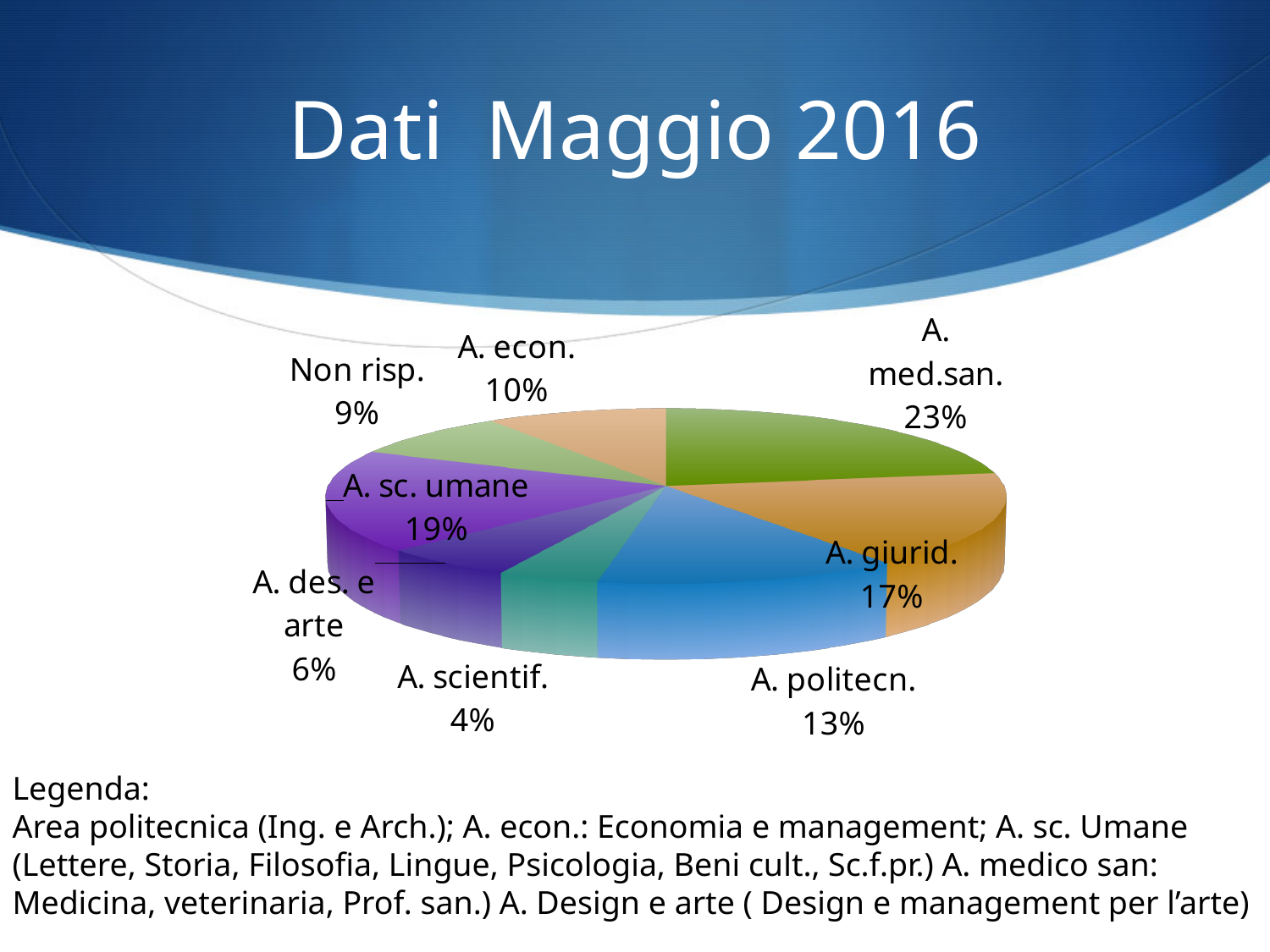
What is the value shown for A. politecn.? 13% What percentage is labelled for Non risp.? 9% Which category has the smallest slice of the pie? A. scientif. What is the difference in percentage points between A. econ. and A. des. e arte? 4 Which category has the largest slice of the pie? A. med.san. What is the title of the slide containing the chart? Dati Maggio 2016 What type of chart is shown on the slide? Pie chart What is the difference in percentage points between A. med.san. and A. giurid.? 6 What share does A. sc. umane have in the pie chart? 19% What percentage of the pie is A. med.san.? 23% Which is larger, A. sc. umane or A. giurid.? A. sc. umane How many slices does the pie chart have? 8